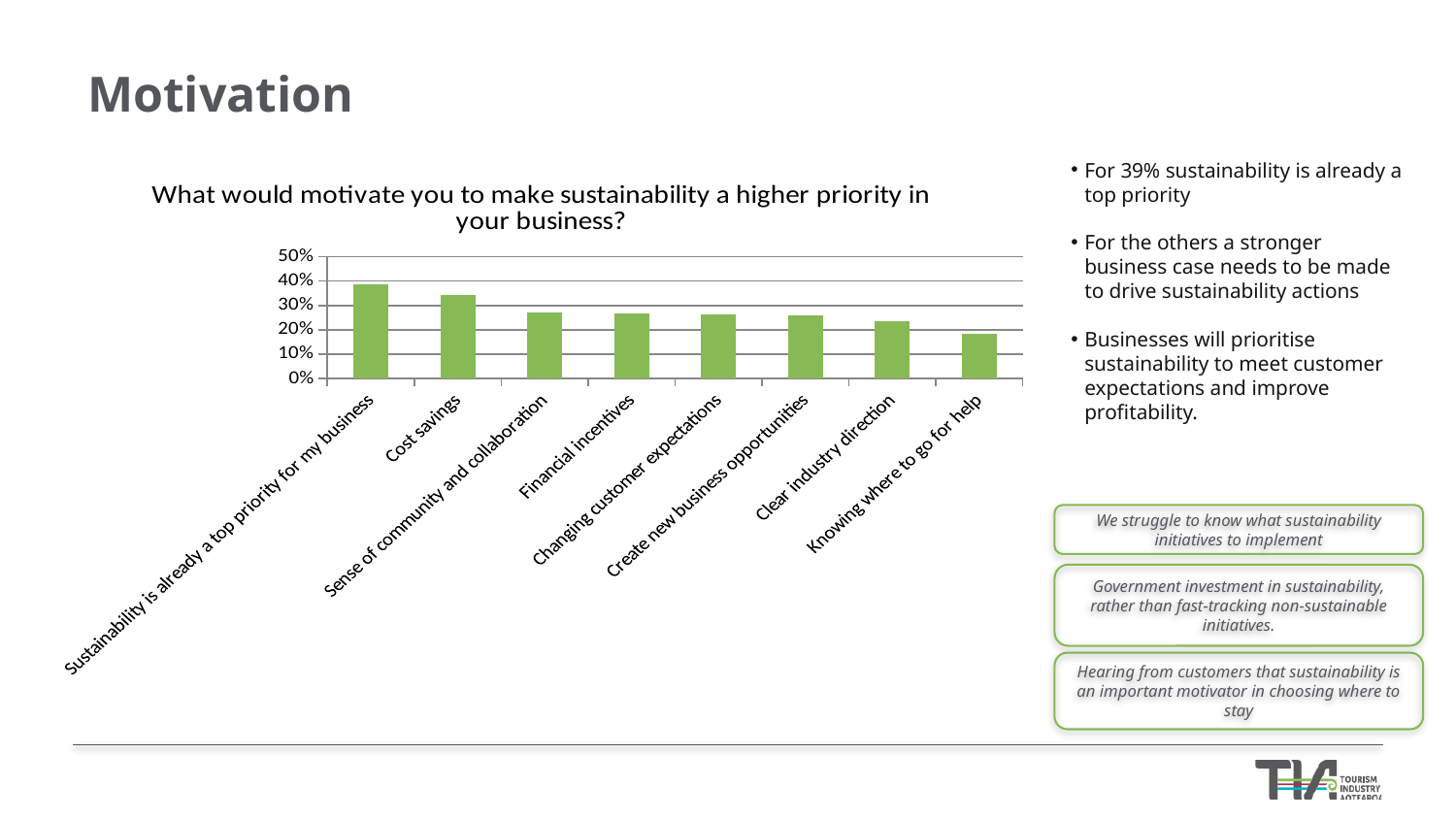
How many categories are shown on the x axis of the chart? 8 Which category has the highest bar in the chart? Sustainability is already a top priority for my business What kind of chart is shown on the slide? Bar chart Which category has the lowest bar in the chart? Knowing where to go for help Is the value for 'Clear industry direction' greater or less than 30%? less Is the value for 'Sustainability is already a top priority for my business' greater or less than 30%? greater Is the value for 'Cost savings' greater or less than 30%? greater Which is larger, the value for 'Cost savings' or the value for 'Knowing where to go for help'? Cost savings What is the highest value shown on the y axis of the chart? 50% What is the title of the chart? What would motivate you to make sustainability a higher priority in your business? Do the bar values generally rise or fall from left to right along the x axis? Fall